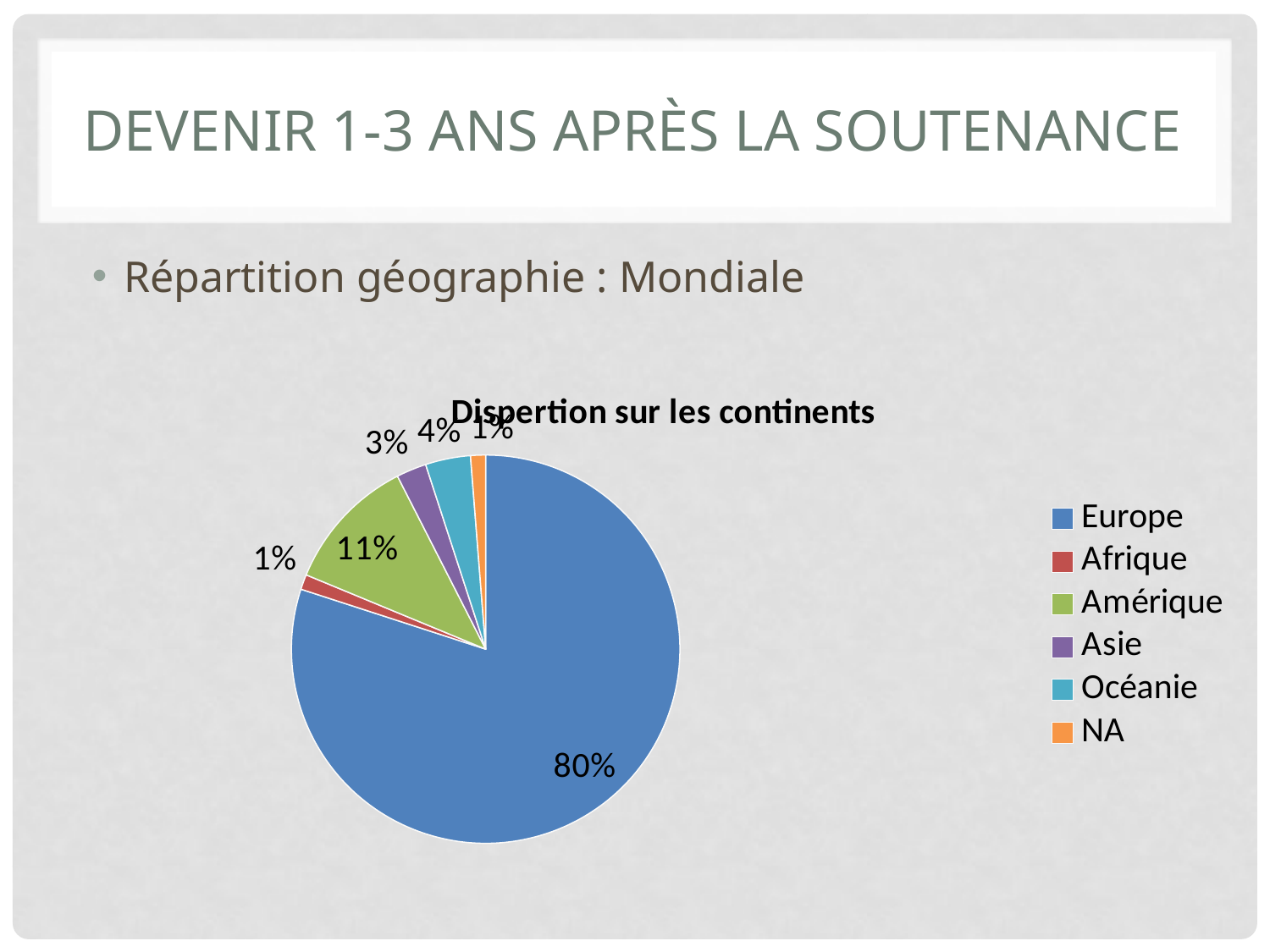
What is the difference between the shares of Europe and Amérique? 69% What share of the pie does Europe represent? 80% What colour is the slice for Amérique? green What is the value shown for Asie? 3% What is the value shown for Océanie? 4% What kind of chart is shown on the slide? pie chart Which category has the largest slice of the pie? Europe What is the value shown for Afrique? 1% Which is larger, the share for Océanie or the share for Asie? Océanie What is the title of the chart? Dispertion sur les continents What share of the pie does Amérique represent? 11% How many categories does the legend list? 6